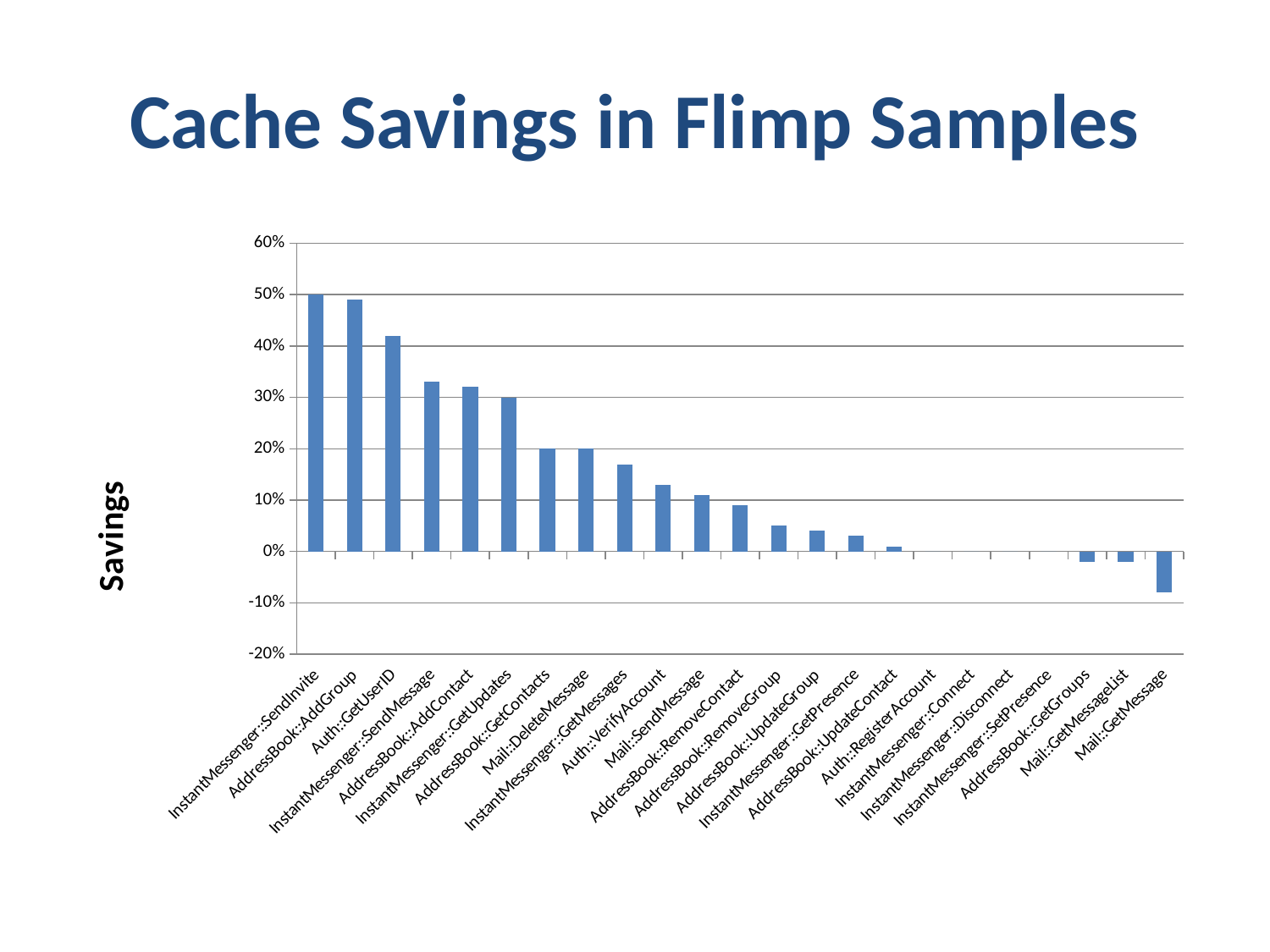
Which is larger, the value for Mail::DeleteMessage or the value for Auth::VerifyAccount? Mail::DeleteMessage What is the label on the vertical axis? Savings What kind of chart is shown on the slide? bar chart How many categories are plotted on the x axis? 23 Do the savings values rise or fall moving left to right along the x axis? fall Is the value for AddressBook::RemoveContact greater or less than 10%? less Is the value for Mail::GetMessage greater or less than 0%? less Which is larger, the value for Auth::GetUserID or the value for InstantMessenger::SendMessage? Auth::GetUserID Is the value for Auth::GetUserID greater or less than 40%? greater Which category has the lowest savings value? Mail::GetMessage What is the title of the chart? Cache Savings in Flimp Samples